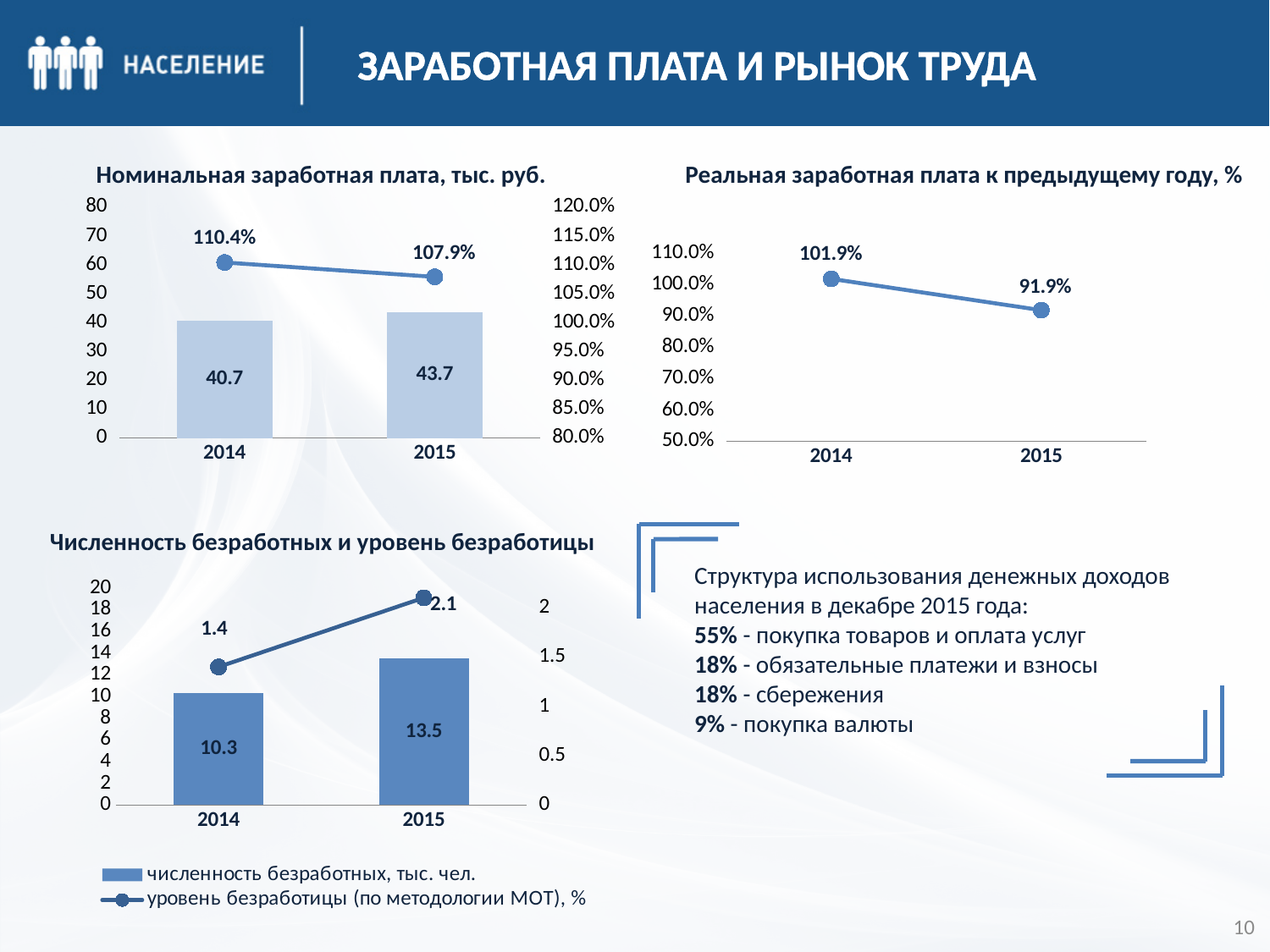
In the chart 'Реальная заработная плата к предыдущему году, %', which year has the higher value? 2014 In the chart 'Номинальная заработная плата, тыс. руб.', what is the difference between the bar values for 2015 and 2014? 3.0 In the chart 'Численность безработных и уровень безработицы', how many series does the legend list? 2 In the chart 'Номинальная заработная плата, тыс. руб.', what is the bar value for 2015? 43.7 In the chart 'Численность безработных и уровень безработицы', does the unemployment rate line rise or fall from 2014 to 2015? rise In the chart 'Номинальная заработная плата, тыс. руб.', does the line rise or fall from 2014 to 2015? fall In the chart 'Номинальная заработная плата, тыс. руб.', what is the line value labelled for 2014? 110.4% How many years (categories) are shown on the x axis of the chart 'Реальная заработная плата к предыдущему году, %'? 2 In the chart 'Реальная заработная плата к предыдущему году, %', what is the difference between the 2014 and 2015 values? 10.0% In the chart 'Численность безработных и уровень безработицы', what is the value of 'численность безработных, тыс. чел.' for 2014? 10.3 In the chart 'Численность безработных и уровень безработицы', what is the value of 'уровень безработицы (по методологии МОТ), %' for 2015? 2.1 In the chart 'Реальная заработная плата к предыдущему году, %', what is the value for 2015? 91.9%